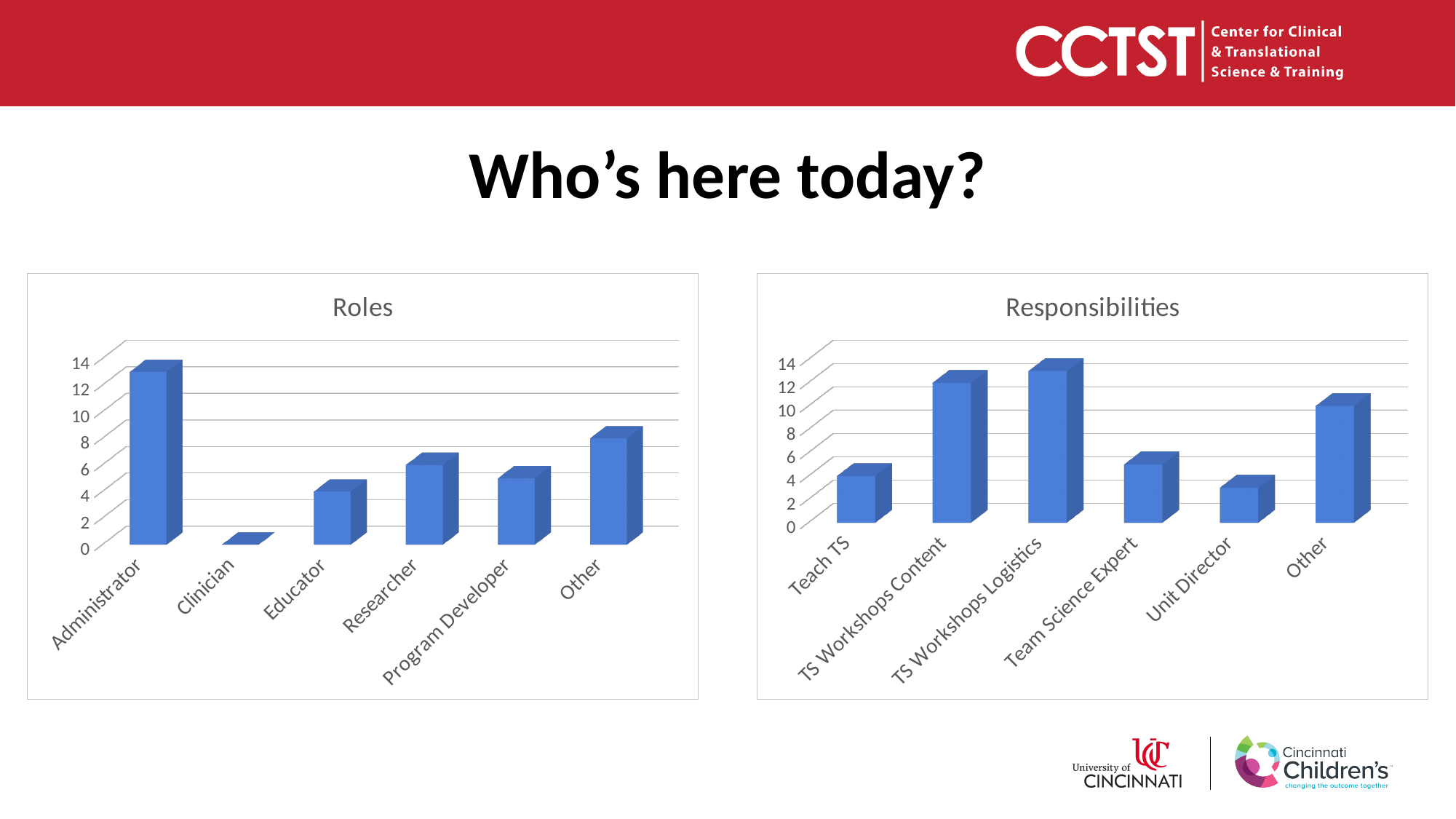
In the Responsibilities chart, which is larger, Other or Teach TS? Other In the Roles chart, which is larger, Researcher or Educator? Researcher How many categories are shown in the Roles chart? 6 In the Roles chart, is the value for Administrator greater or less than 10? greater What type of chart is the Roles chart? bar chart In the Roles chart, is the value for Other greater or less than 10? less In the Responsibilities chart, is the value for TS Workshops Content greater or less than 10? greater In the Roles chart, which category has the highest value? Administrator How many categories are shown in the Responsibilities chart? 6 What is the title of the chart on the right side of the slide? Responsibilities In the Roles chart, which category has the lowest value? Clinician